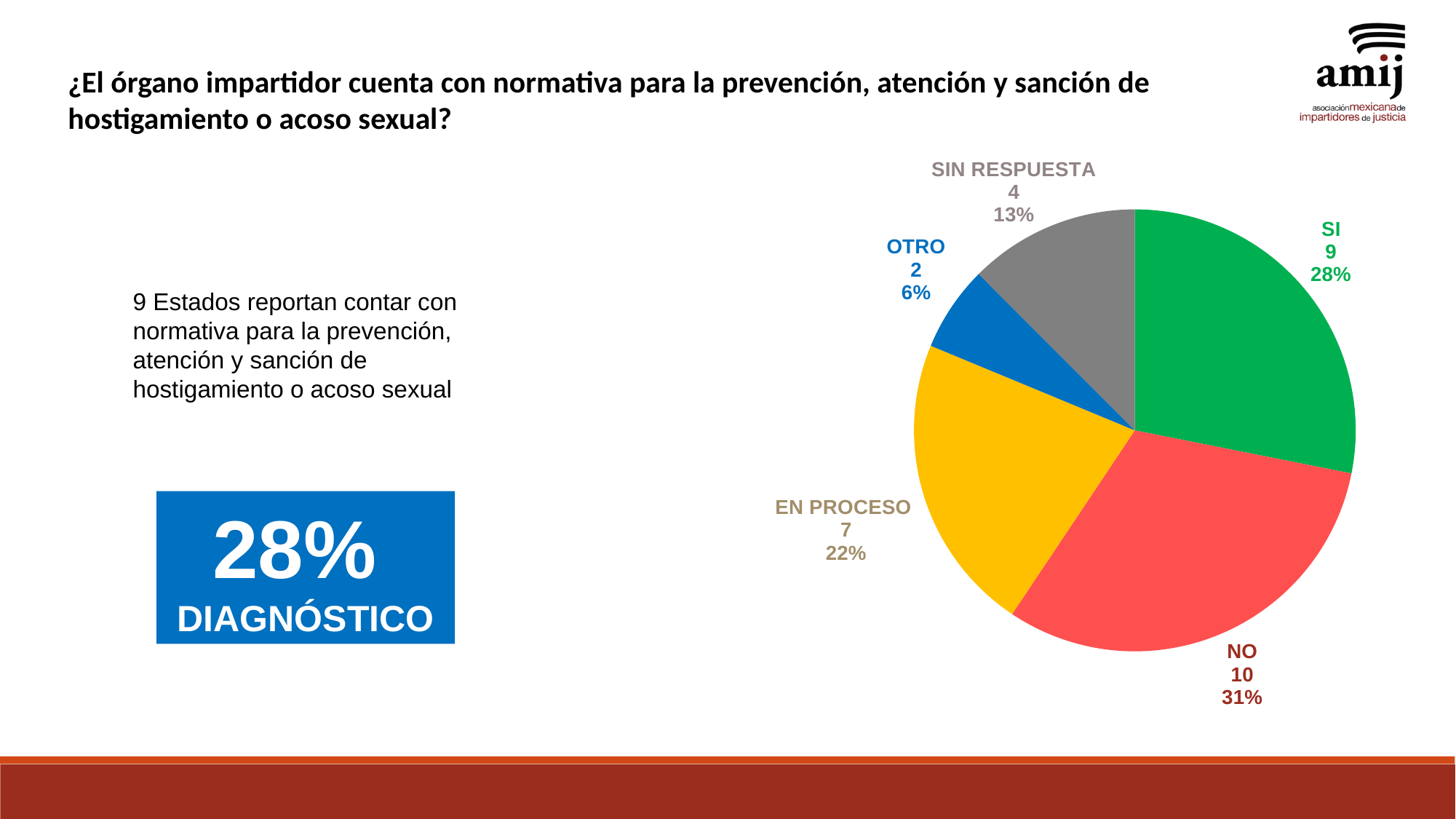
How many slices does the pie chart have? 5 Which category has the smallest slice? OTRO Which category has the largest slice? NO What is the count for EN PROCESO? 7 What kind of chart is shown on the slide? pie chart What percentage share does the SI slice have? 28% What colour is the SI slice? green What percentage share does the SIN RESPUESTA slice have? 13% What is the total count across all slices of the pie chart? 32 Which is larger, the count for EN PROCESO or the count for SIN RESPUESTA? EN PROCESO What is the difference in count between NO and SI? 1 What is the count for the NO slice? 10